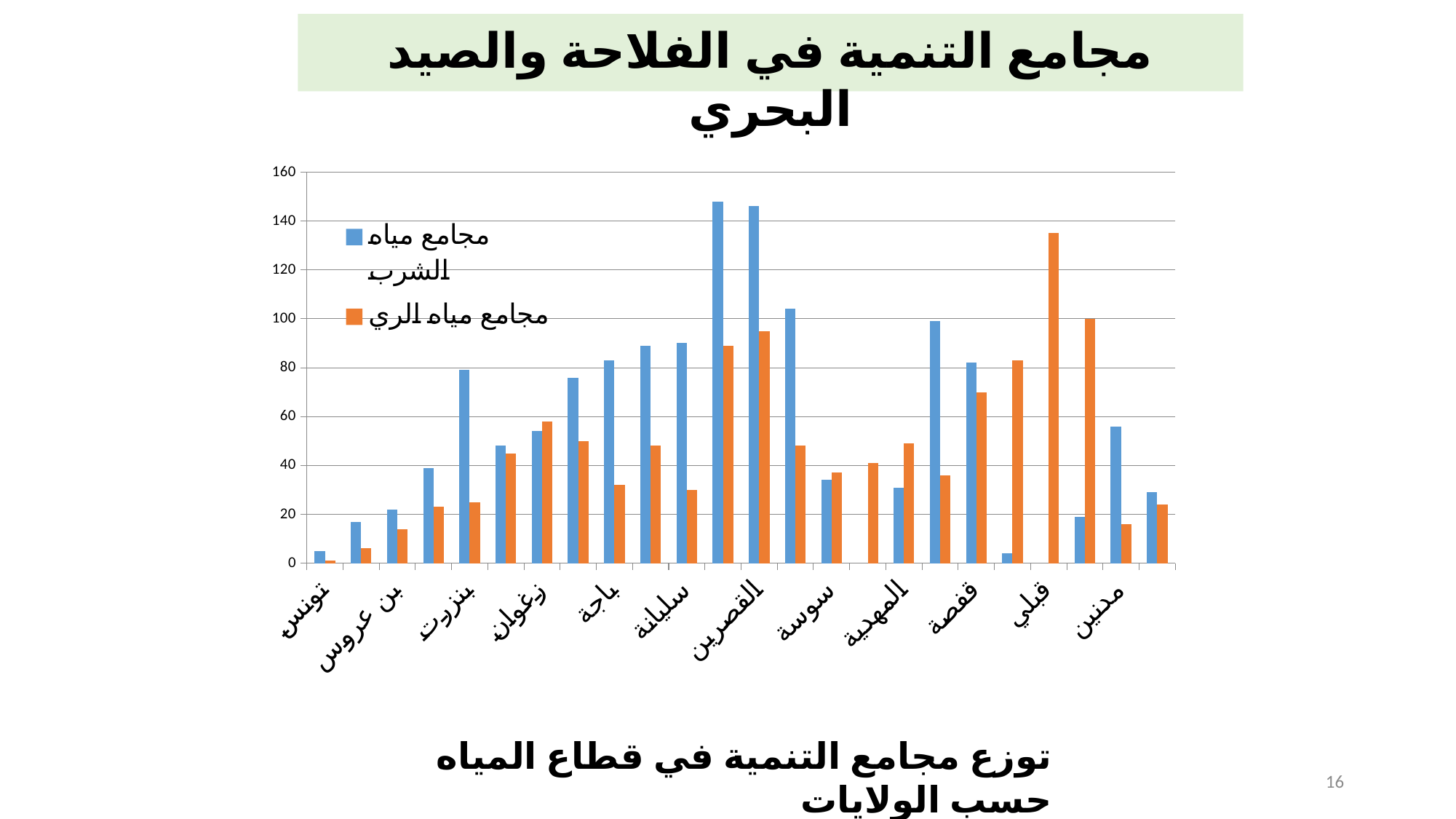
What kind of chart is shown on the slide? bar chart How many series does the legend list? 2 For بنزرت, which series has the larger value, مجامع مياه الشرب or مجامع مياه الري? مجامع مياه الشرب Is the value of مجامع مياه الشرب for القصرين greater or less than 140? greater Among the labelled governorates, which has the highest value for مجامع مياه الري? قبلي Which series contains the tallest bar on the chart? مجامع مياه الشرب Is the value of مجامع مياه الري for قبلي greater or less than 120? greater For مدنين, which series has the larger value, مجامع مياه الشرب or مجامع مياه الري? مجامع مياه الشرب For المهدية, which series has the larger value, مجامع مياه الشرب or مجامع مياه الري? مجامع مياه الري Is the value of مجامع مياه الشرب for سليانة greater or less than 80? greater Which series is shown in blue according to the legend? مجامع مياه الشرب